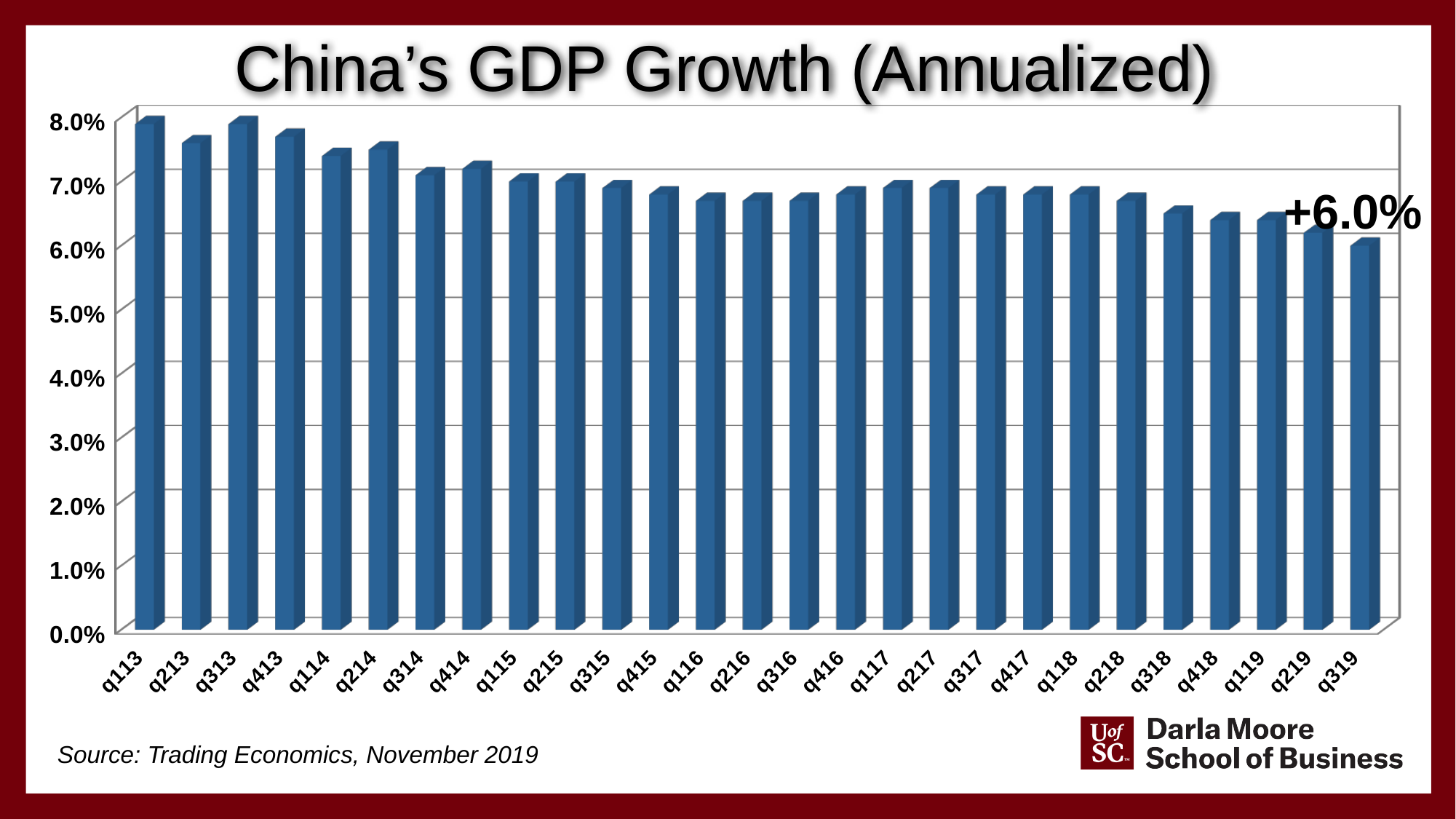
Is the value for q214 greater or less than 7.0%? greater Is the value for q119 greater or less than 6.0%? greater Is the value for q113 greater or less than 7.0%? greater What source is cited for the chart data? Trading Economics, November 2019 Which is larger, the value for q113 or the value for q319? q113 What is the title of the chart? China's GDP Growth (Annualized) Do the values generally rise or fall from q113 to q319? fall How many quarters (bars) are plotted in the chart? 27 What kind of chart is shown on the slide? bar chart What value is labelled on the bar for q319? +6.0% Which quarter has the lowest GDP growth in the chart? q319